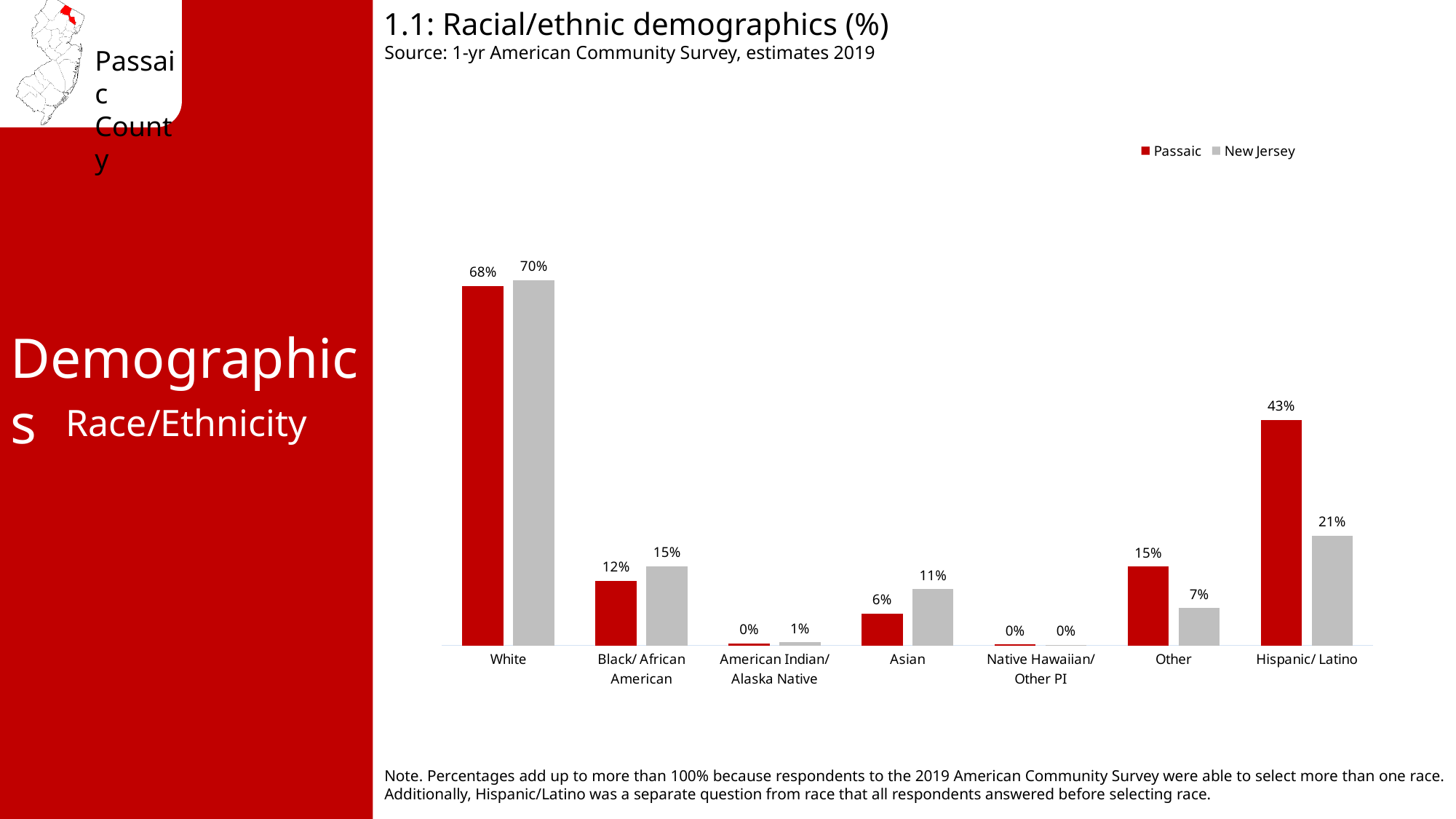
What kind of chart is shown? Bar chart Which category has the highest New Jersey value? White What is the Passaic value for White? 68% What is the difference between the New Jersey and Passaic values for Asian? 5% What is the New Jersey value for Other? 7% Which category has the highest Passaic value? White What is the New Jersey value for Hispanic/ Latino? 21% How many series does the legend list? 2 How many categories are shown on the x axis? 7 What is the Passaic value for Asian? 6% Which is larger for Other: the Passaic value or the New Jersey value? Passaic What is the difference between the Passaic and New Jersey values for Hispanic/ Latino? 22%